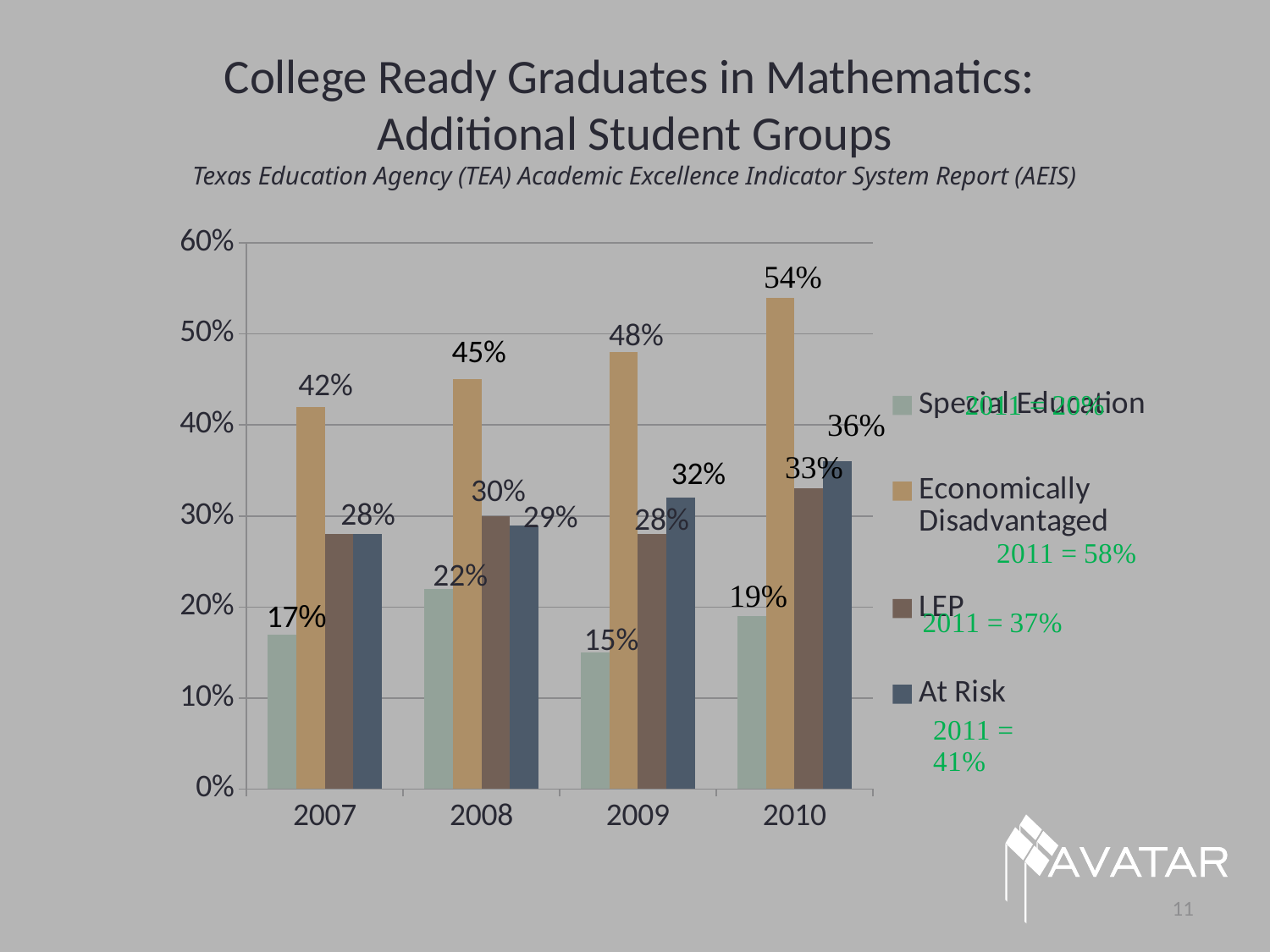
What is the value for At Risk in 2009? 32% In 2010, which is larger: the At Risk value or the LEP value? At Risk What is the value for Economically Disadvantaged in 2010? 54% How many series does the legend list? 4 Is the value for At Risk in 2007 greater or less than 30%? less How many years are shown on the x axis? 4 What is the difference between the Economically Disadvantaged values in 2010 and 2007? 12 percentage points In which year is the Special Education value lowest? 2009 Do the Economically Disadvantaged values rise or fall from 2007 to 2010? rise What kind of chart is shown on the slide? bar chart In which year is the Economically Disadvantaged value highest? 2010 What is the value for Special Education in 2009? 15%